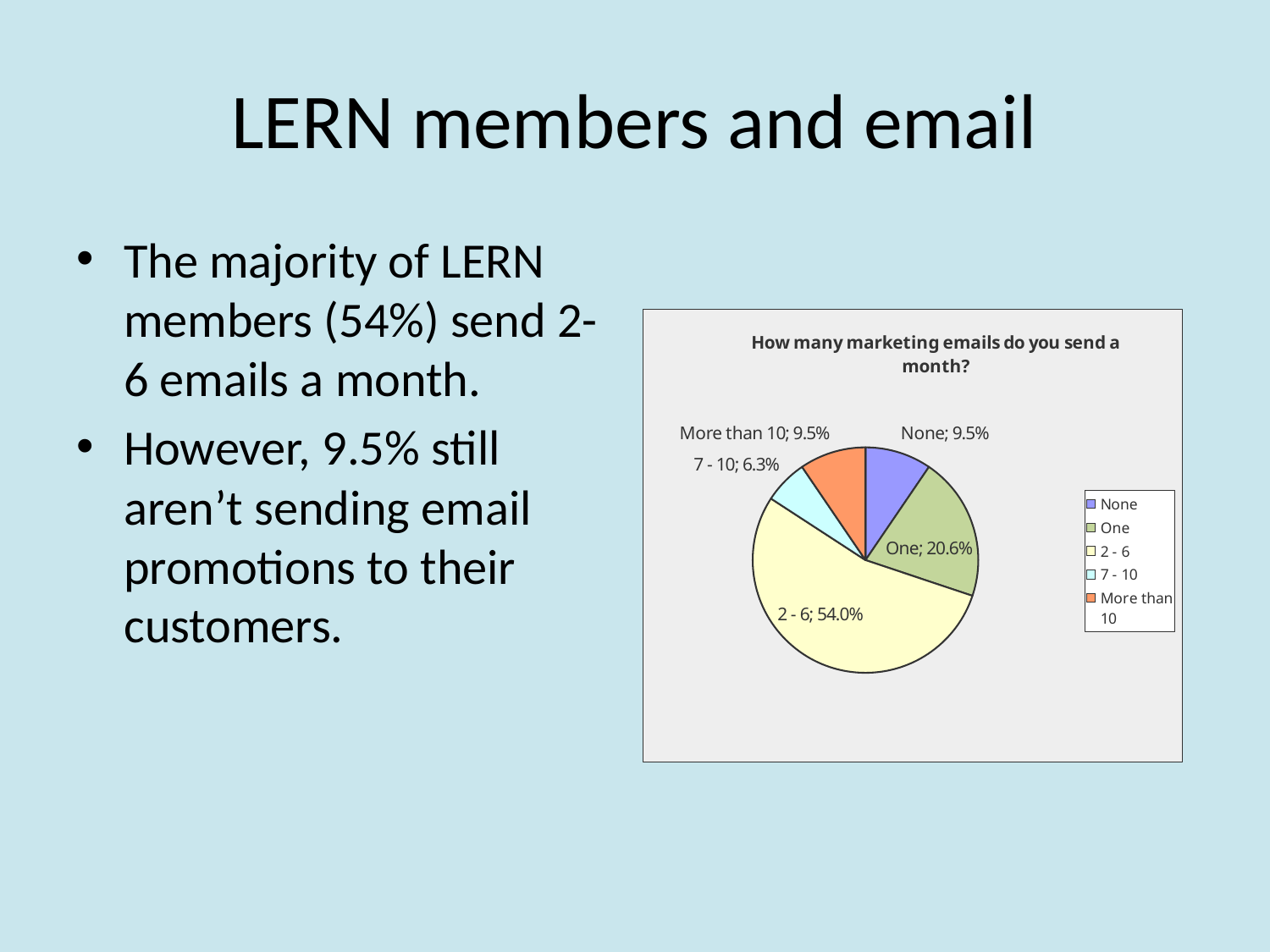
What kind of chart is shown on the slide? pie chart What share of the pie is the "None" slice? 9.5% Which category has the smallest slice of the pie? 7 - 10 What share of the pie is the "More than 10" slice? 9.5% What is the difference between the "2 - 6" share and the "One" share? 33.4% How many categories does the pie chart have? 5 What share of the pie is the "One" slice? 20.6% What is the title of the chart? How many marketing emails do you send a month? Which category has the largest slice of the pie? 2 - 6 Which is larger, the "One" slice or the "None" slice? One